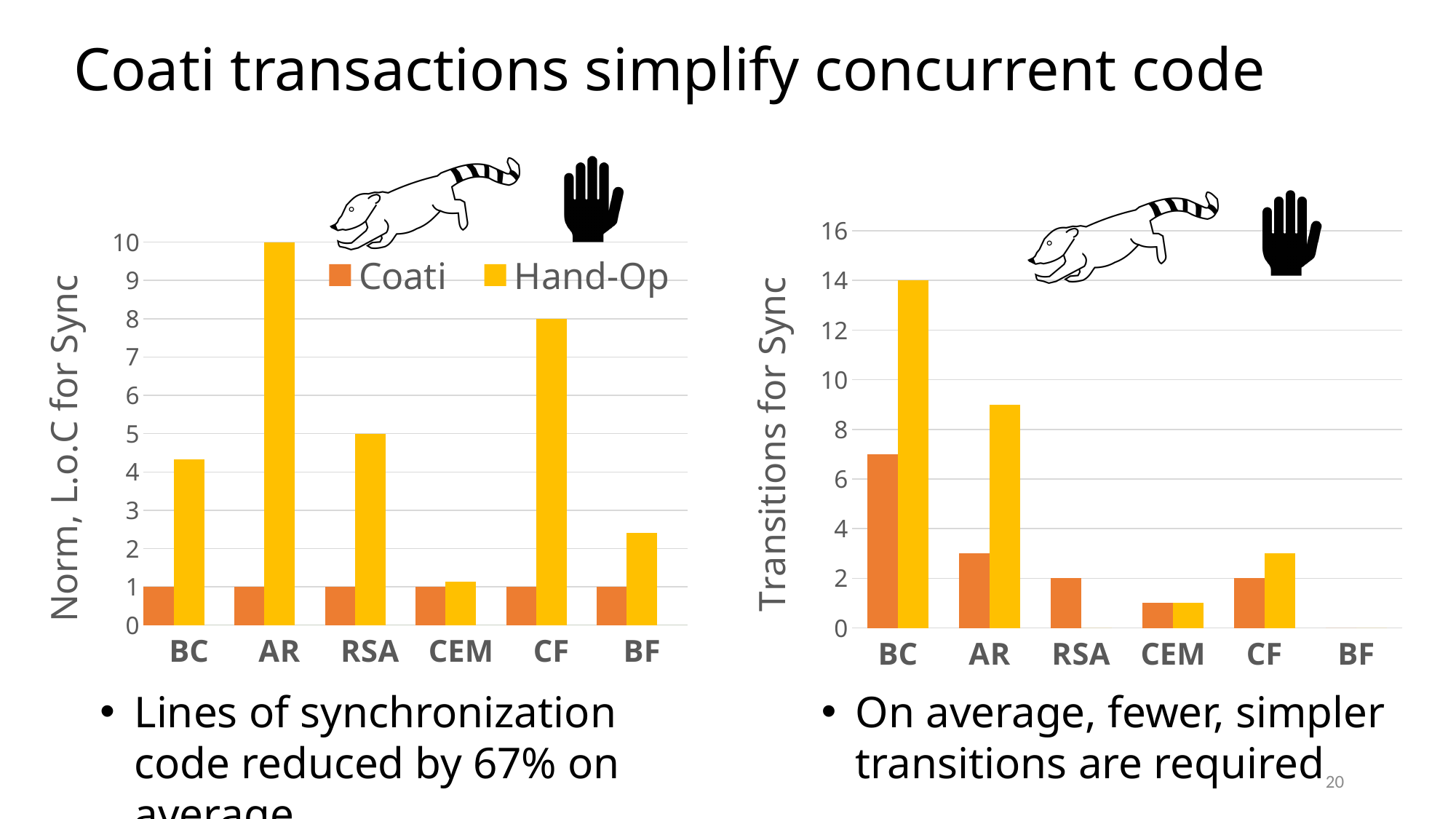
In the left chart (Norm, L.o.C for Sync), what is the difference between the Hand-Op values for AR and CF? 2 In the right chart (Transitions for Sync), what is the Hand-Op value for BC? 14 In the left chart (Norm, L.o.C for Sync), which category has the highest Hand-Op value? AR What kind of chart is the left chart (Norm, L.o.C for Sync)? bar chart In the left chart (Norm, L.o.C for Sync), is the Hand-Op value for BC greater or less than 4? greater In the left chart (Norm, L.o.C for Sync), what is the Hand-Op value for CF? 8 In the right chart (Transitions for Sync), is the Coati value for BC greater or less than 6? greater In the left chart (Norm, L.o.C for Sync), what is the Hand-Op value for RSA? 5 How many series does the legend on the left chart list? 2 In the right chart (Transitions for Sync), which series has the larger value for AR, Coati or Hand-Op? Hand-Op How many categories are shown on the x axis of the right chart (Transitions for Sync)? 6 In the left chart (Norm, L.o.C for Sync), what is the Hand-Op value for AR? 10